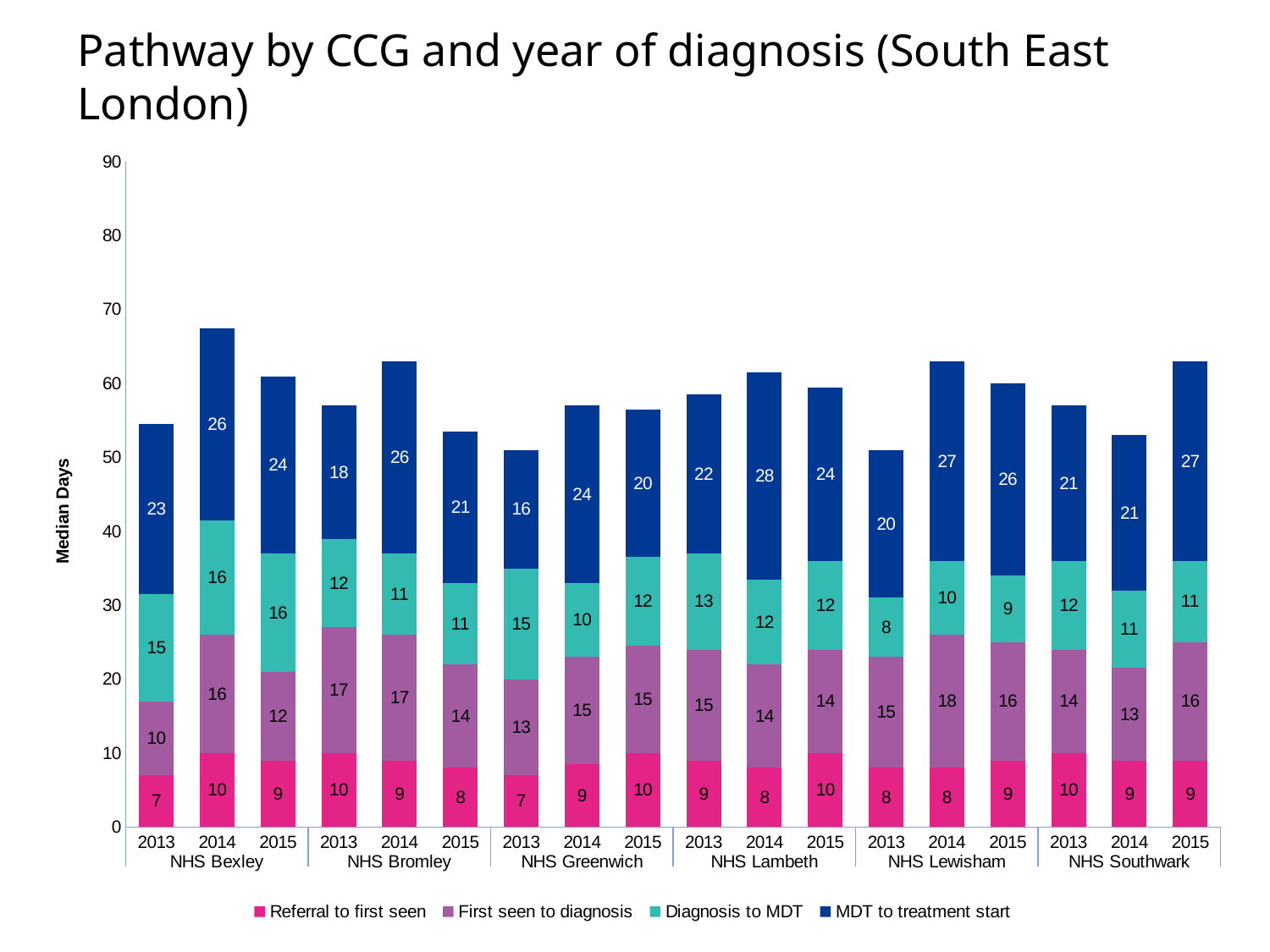
What is the median days for First seen to diagnosis for NHS Lewisham in 2014? 18 What is the difference between the MDT to treatment start values for NHS Bexley 2014 and NHS Bexley 2013? 3 Is the total for the NHS Bexley 2014 bar greater or less than 60? greater How many bars are plotted in the chart? 18 Which bar has the highest value for MDT to treatment start? NHS Lambeth 2014 What is the total median days for the NHS Bexley 2014 bar? 68 What type of chart is shown on the slide? Stacked bar chart What is the median days for MDT to treatment start for NHS Lambeth in 2014? 28 Which bar has the lowest value for Diagnosis to MDT? NHS Lewisham 2013 What is the median days for Referral to first seen for NHS Bexley in 2013? 7 How many series does the legend list? 4 Which is larger: Diagnosis to MDT for NHS Bexley 2013 or for NHS Greenwich 2014? NHS Bexley 2013